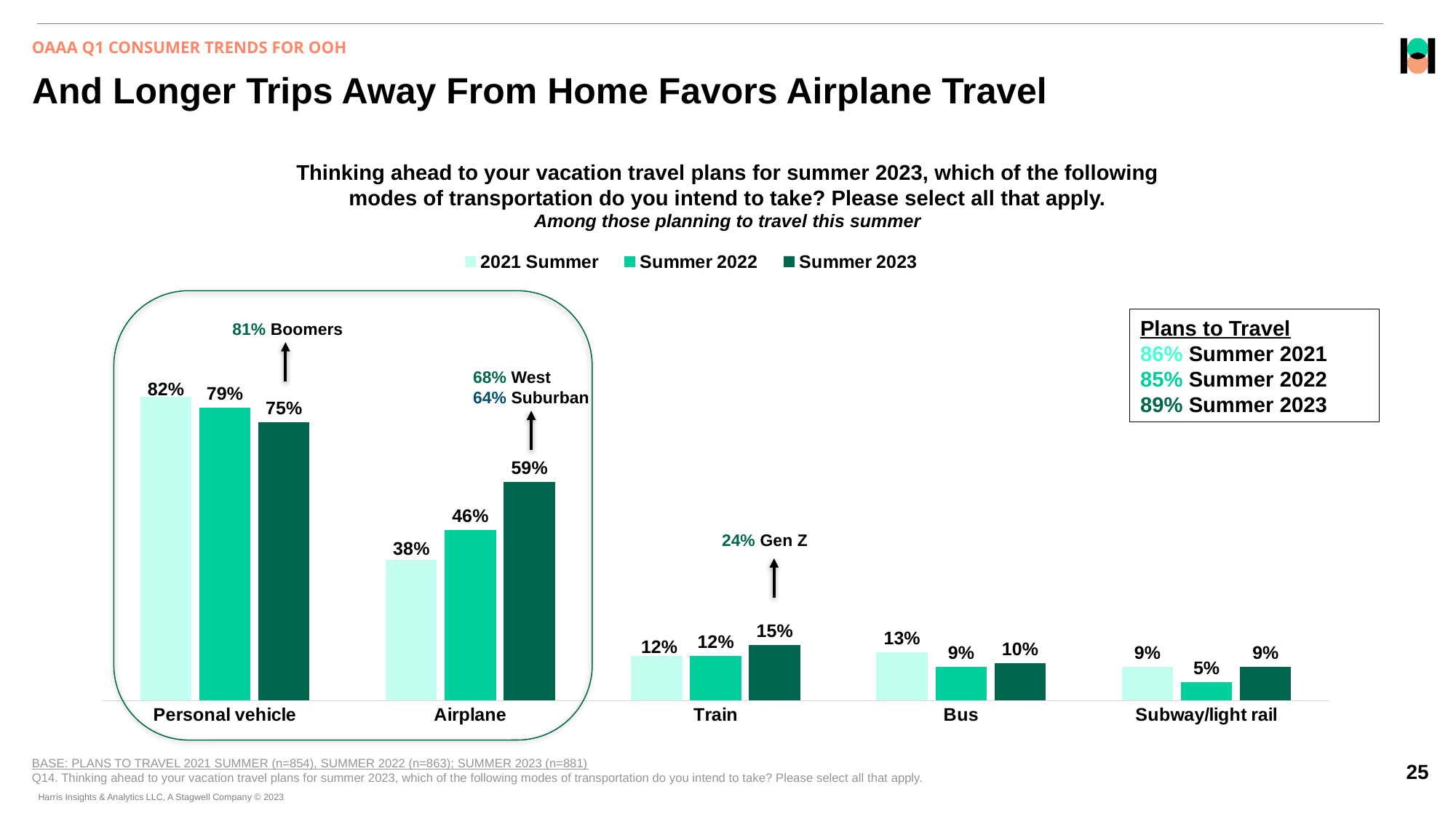
Which mode of transportation has the lowest Summer 2022 value? Subway/light rail What is the Summer 2023 value for Airplane? 59% Which mode of transportation has the highest Summer 2023 value? Personal vehicle How many modes of transportation are shown on the x axis? 5 What is the difference between the Summer 2023 and 2021 Summer values for Airplane? 21% What is the Summer 2022 value for Subway/light rail? 5% How many series does the legend list? 3 What kind of chart is shown on the slide? Bar chart What is the 2021 Summer value for Personal vehicle? 82% What is the Summer 2023 value for Train? 15% Which is larger for Bus: the 2021 Summer value or the Summer 2023 value? 2021 Summer Do the Personal vehicle values rise or fall from 2021 Summer to Summer 2023? Fall